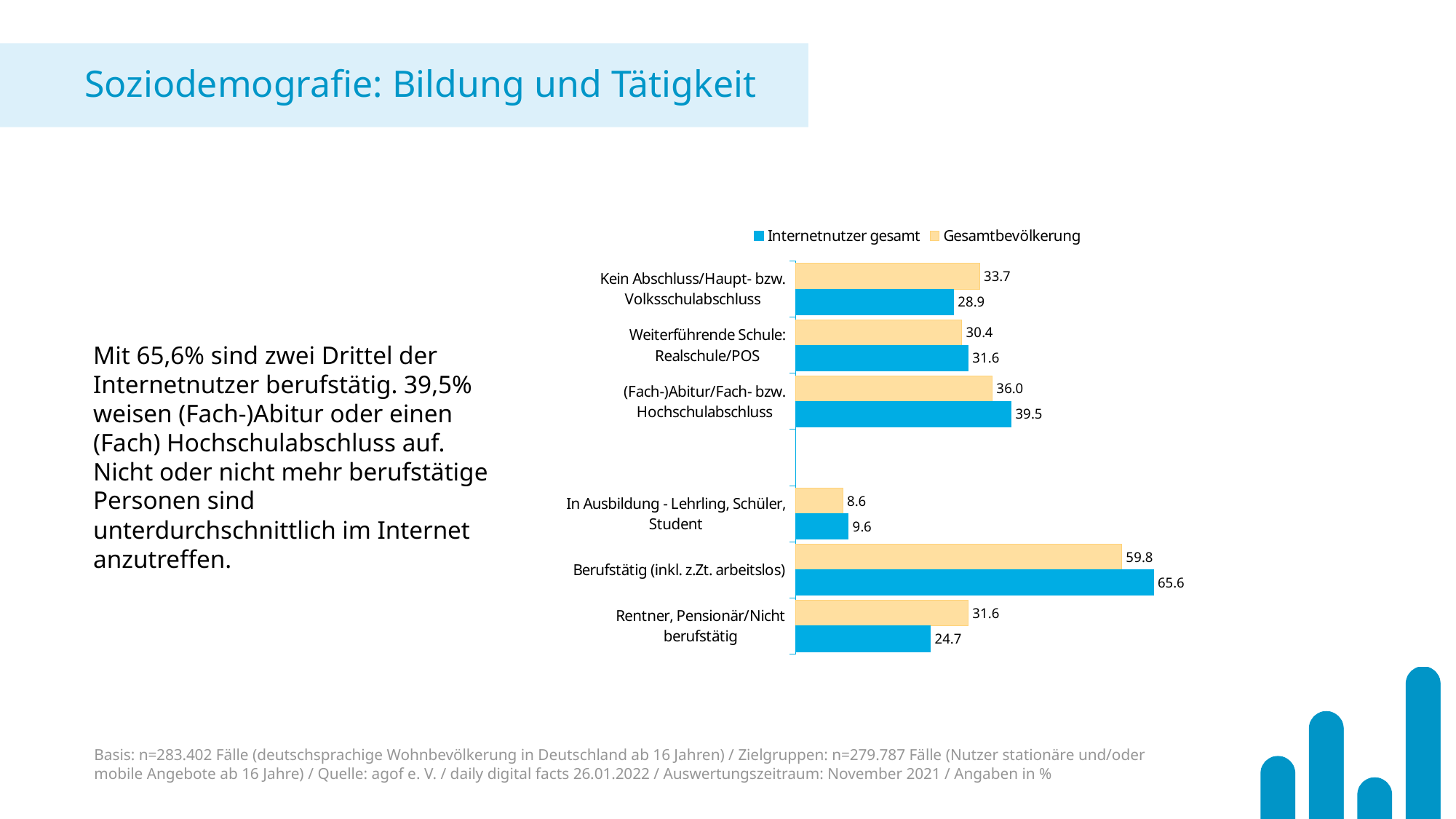
What kind of chart is shown on the slide? Bar chart What is the value for Gesamtbevölkerung in the category In Ausbildung - Lehrling, Schüler, Student? 8.6 What is the value for Internetnutzer gesamt in the category Berufstätig (inkl. z.Zt. arbeitslos)? 65.6 What is the difference between Internetnutzer gesamt and Gesamtbevölkerung in the category Rentner, Pensionär/Nicht berufstätig? 6.9 How many categories are shown on the chart? 6 What is the difference between Internetnutzer gesamt and Gesamtbevölkerung in the category Berufstätig (inkl. z.Zt. arbeitslos)? 5.8 In the category Kein Abschluss/Haupt- bzw. Volksschulabschluss, which series has the larger value, Internetnutzer gesamt or Gesamtbevölkerung? Gesamtbevölkerung In the category (Fach-)Abitur/Fach- bzw. Hochschulabschluss, which series has the larger value, Internetnutzer gesamt or Gesamtbevölkerung? Internetnutzer gesamt What is the value for Gesamtbevölkerung in the category Kein Abschluss/Haupt- bzw. Volksschulabschluss? 33.7 How many series does the legend list? 2 Which category has the lowest value for Gesamtbevölkerung? In Ausbildung - Lehrling, Schüler, Student Which category has the highest value for Internetnutzer gesamt? Berufstätig (inkl. z.Zt. arbeitslos)